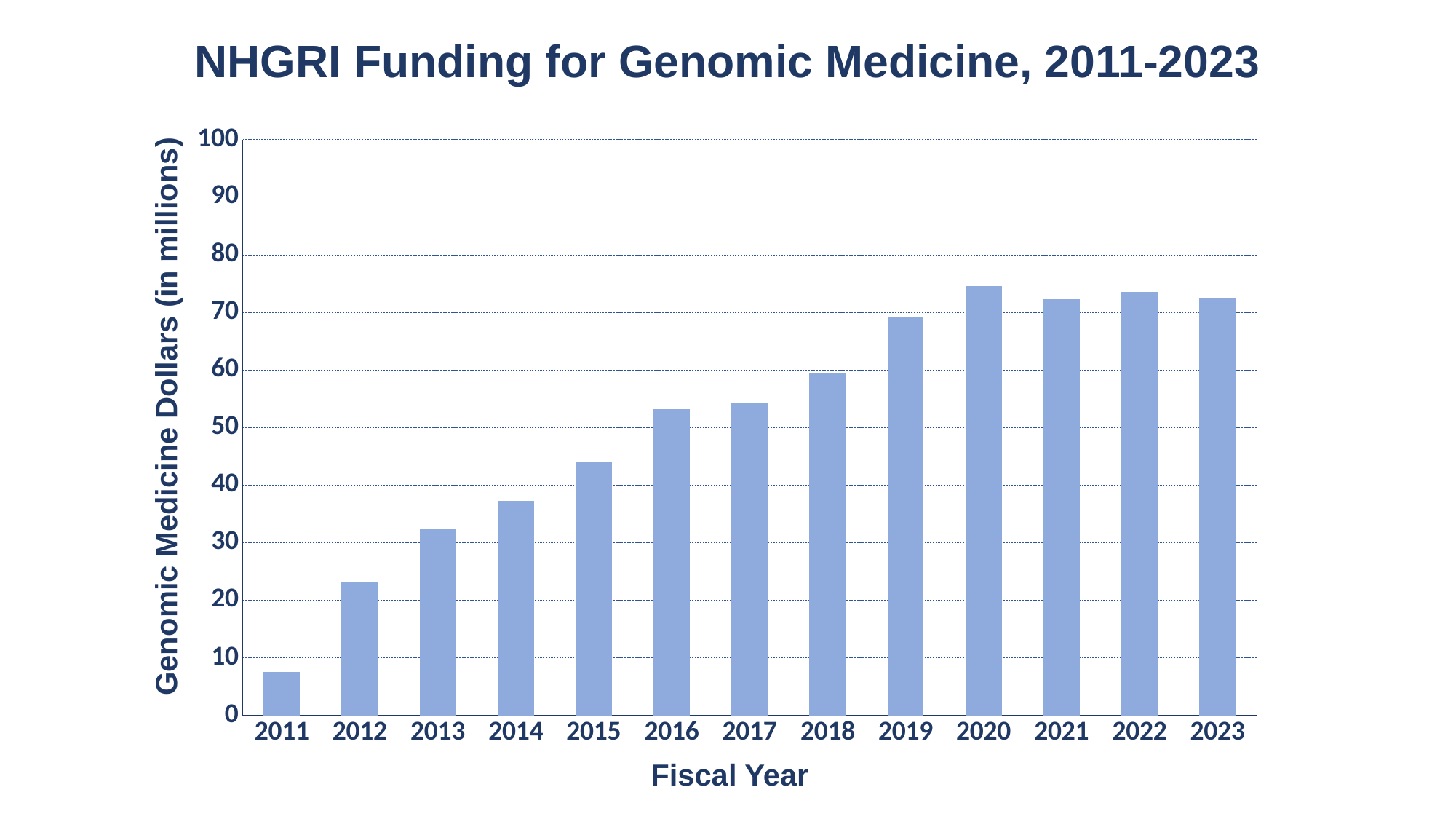
Do the values generally rise or fall from 2011 to 2020? rise Is the value for 2011 greater or less than 10? less Is the value for 2015 greater or less than 40? greater How many fiscal years are plotted on the chart? 13 Which is larger, the value for 2012 or the value for 2013? 2013 Which fiscal year has the lowest funding value? 2011 Is the value for 2020 greater or less than 70? greater What kind of chart is shown on the slide? bar chart Which is larger, the value for 2018 or the value for 2019? 2019 What is the title of the chart? NHGRI Funding for Genomic Medicine, 2011-2023